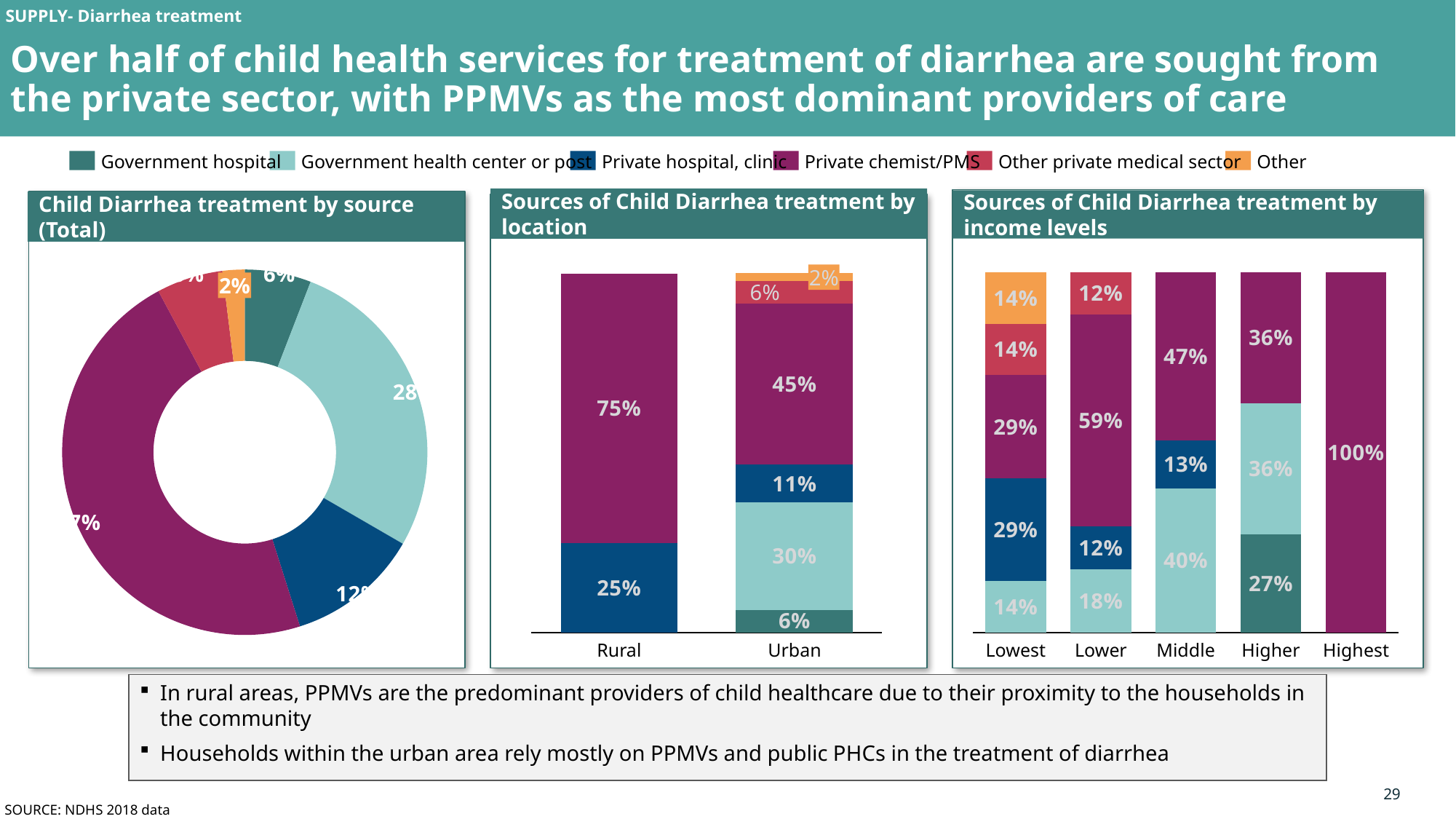
In the 'Sources of Child Diarrhea treatment by income levels' chart, which income level has the highest Private chemist/PMS share? Highest How many series does the shared legend at the top of the slide list? 6 In the 'Sources of Child Diarrhea treatment by location' chart, what share of Rural treatment comes from Private chemist/PMS? 75% In the 'Sources of Child Diarrhea treatment by location' chart, how much larger is the Private chemist/PMS share for Rural than for Urban? 30 percentage points In the 'Sources of Child Diarrhea treatment by location' chart, what is the Private hospital, clinic share for Rural? 25% What kind of chart is 'Child Diarrhea treatment by source (Total)'? Pie (donut) chart In the 'Sources of Child Diarrhea treatment by income levels' chart, what is the Private chemist/PMS share for the Highest income level? 100% In the 'Sources of Child Diarrhea treatment by location' chart, what is the Government health center or post share for Urban? 30% In the 'Sources of Child Diarrhea treatment by income levels' chart, what is the Government hospital share for the Higher income level? 27% In the 'Sources of Child Diarrhea treatment by location' chart, which is larger for Urban: Private chemist/PMS or Government health center or post? Private chemist/PMS How many income levels are shown in the 'Sources of Child Diarrhea treatment by income levels' chart? 5 In the 'Sources of Child Diarrhea treatment by income levels' chart, what is the Private chemist/PMS share for the Lower income level? 59%